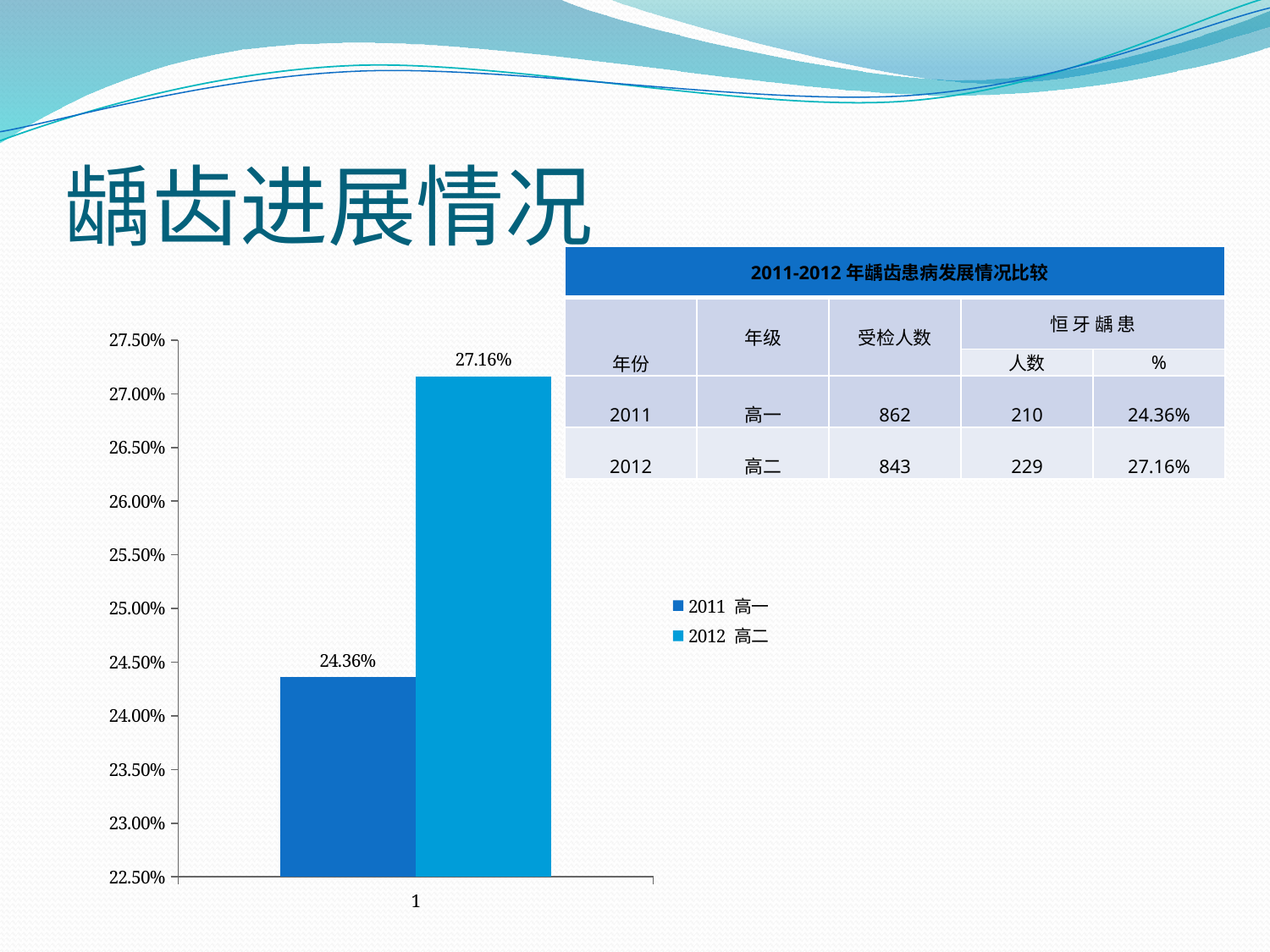
Which series has the lower value in the bar chart? 2011 高一 What is the value for the 2011 高一 series in the bar chart? 24.36% What is the value for the 2012 高二 series in the bar chart? 27.16% Which series has the higher value in the bar chart? 2012 高二 What is the lowest value shown on the y axis of the bar chart? 22.50% Is the value for 2012 高二 greater or less than 27.00%? greater Is the value for 2011 高一 greater or less than 25.00%? less How many series does the legend of the bar chart list? 2 What kind of chart is shown on the slide? bar chart What is the label on the x axis category of the bar chart? 1 What is the difference between the 2012 高二 value and the 2011 高一 value in the bar chart? 2.80% Does the value rise or fall from the 2011 高一 bar to the 2012 高二 bar? rise